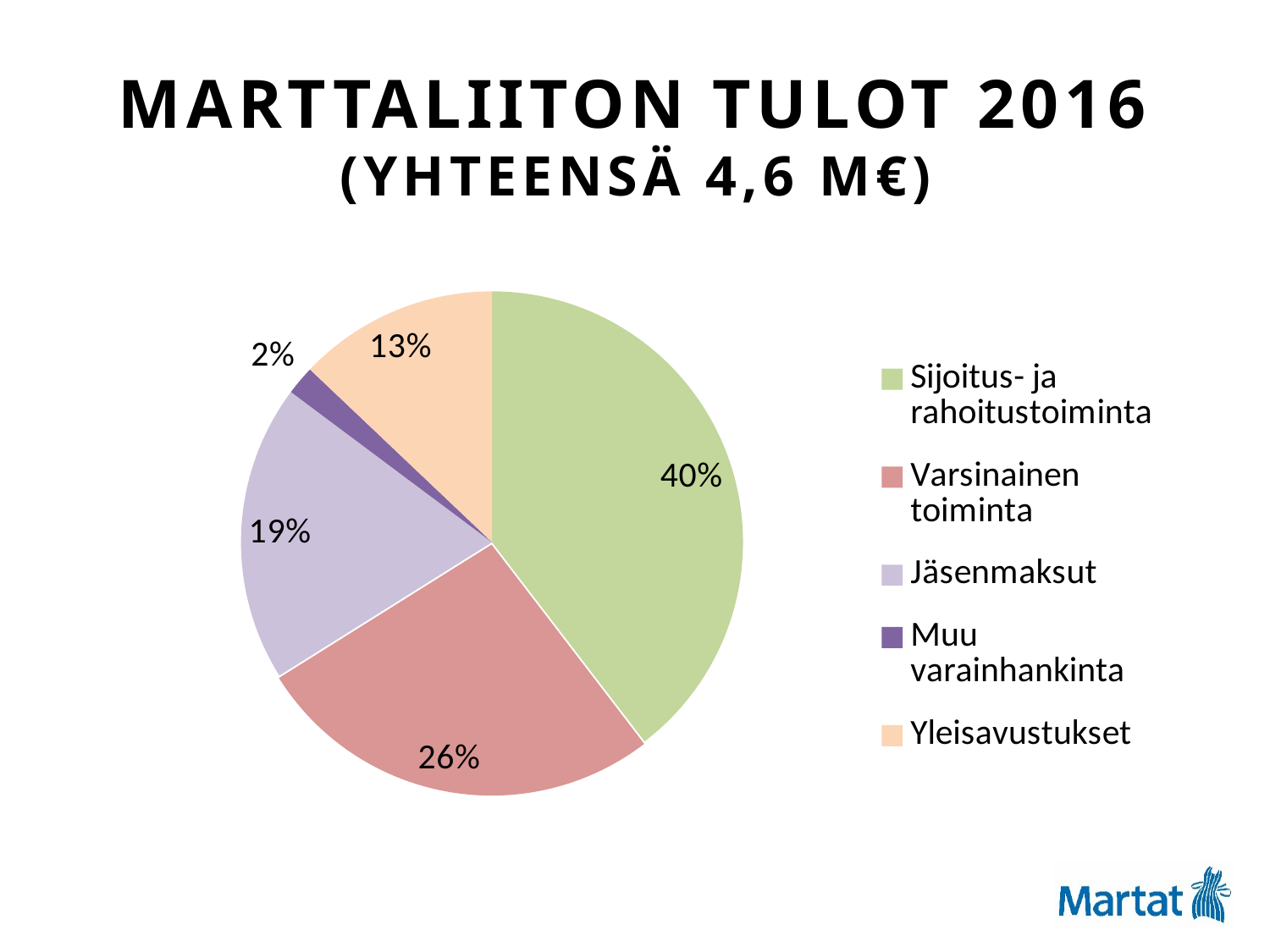
What share of the pie does Muu varainhankinta have? 2% Which is larger, the share for Jäsenmaksut or the share for Yleisavustukset? Jäsenmaksut What is the difference in percentage points between Sijoitus- ja rahoitustoiminta and Varsinainen toiminta? 14 percentage points What share of the pie does Sijoitus- ja rahoitustoiminta have? 40% Which category has the largest slice of the pie? Sijoitus- ja rahoitustoiminta Which category has the smallest slice of the pie? Muu varainhankinta What is the title of the chart on the slide? MARTTALIITON TULOT 2016 (YHTEENSÄ 4,6 M€) What share of the pie does Jäsenmaksut have? 19% How many categories does the pie chart have? 5 What kind of chart is shown on the slide? pie chart